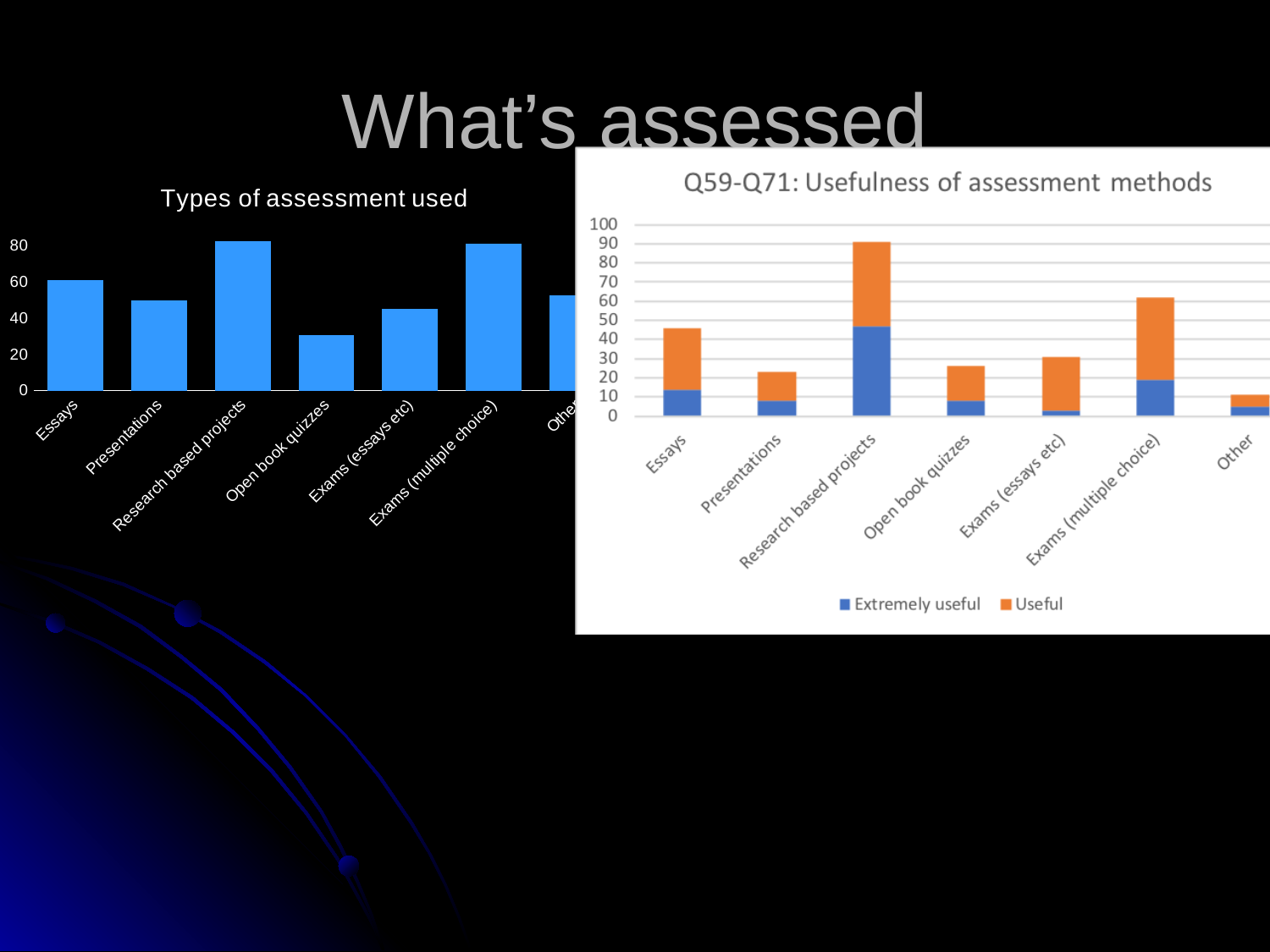
In the "Q59-Q71: Usefulness of assessment methods" chart, which category has the lowest total bar? Other In the "Q59-Q71: Usefulness of assessment methods" chart, how many series does the legend list? 2 In the "Q59-Q71: Usefulness of assessment methods" chart, how many categories are shown on the x axis? 7 In the "Types of assessment used" chart, which category has the lowest value? Open book quizzes In the "Q59-Q71: Usefulness of assessment methods" chart, is the total value for Other greater or less than 20? less In the "Q59-Q71: Usefulness of assessment methods" chart, is the total value for Research based projects greater or less than 80? greater In the "Q59-Q71: Usefulness of assessment methods" chart, which category has the highest total bar? Research based projects What type of chart is the "Types of assessment used" chart on the left? bar chart In the "Q59-Q71: Usefulness of assessment methods" chart, what colour represents the "Useful" series? orange What type of chart is the "Q59-Q71: Usefulness of assessment methods" chart on the right? stacked bar chart In the "Types of assessment used" chart, is the value for Essays greater or less than 40? greater In the "Q59-Q71: Usefulness of assessment methods" chart, which is larger: the total for Exams (multiple choice) or the total for Exams (essays etc)? Exams (multiple choice)